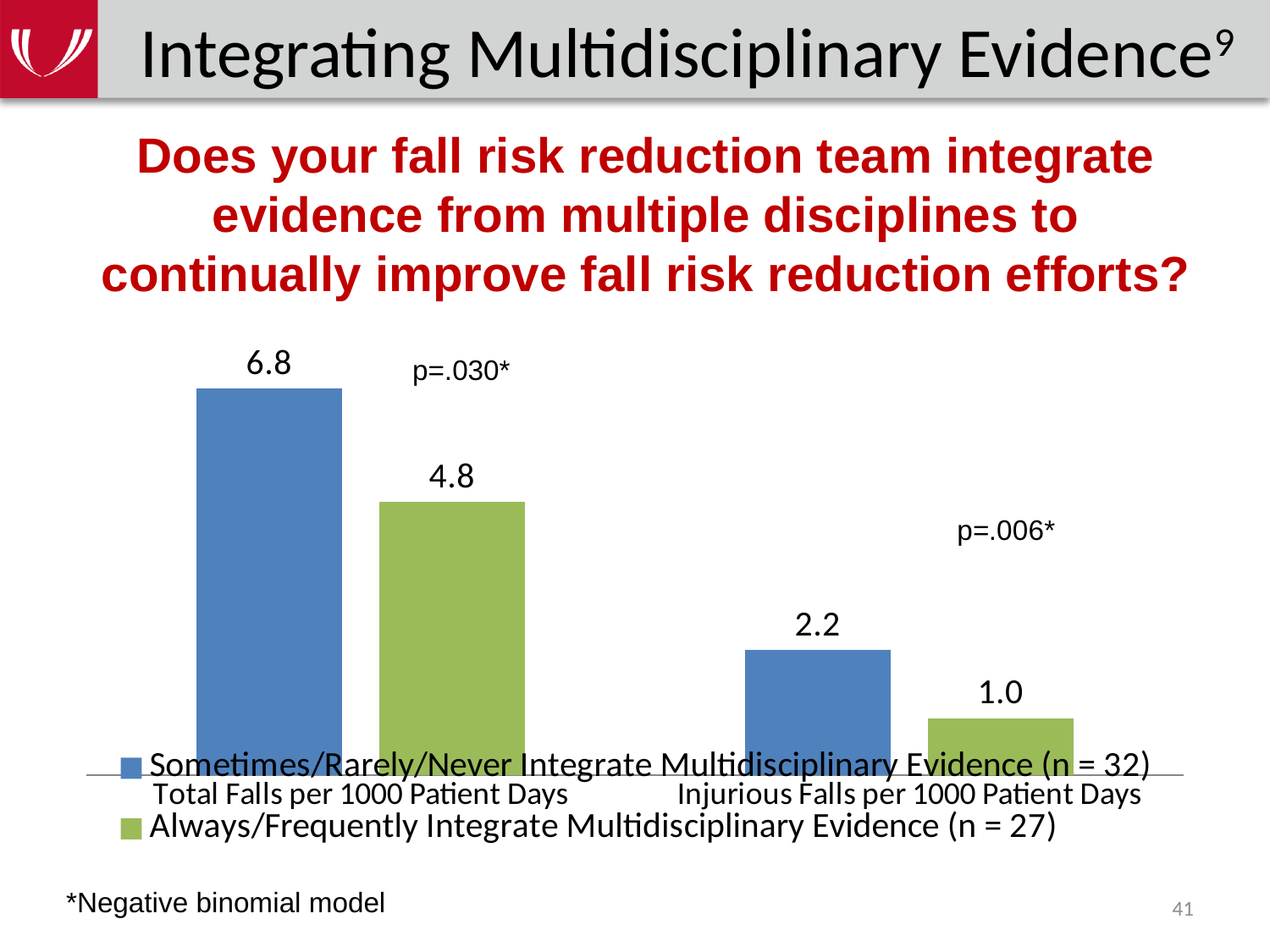
For Injurious Falls per 1000 Patient Days, which group has the larger value? Sometimes/Rarely/Never Integrate Multidisciplinary Evidence (n = 32) Which bar has the lowest value on the chart? Always/Frequently Integrate Multidisciplinary Evidence, Injurious Falls per 1000 Patient Days What is the value for Total Falls per 1000 Patient Days for the Always/Frequently Integrate Multidisciplinary Evidence group? 4.8 What is the difference between the two groups for Total Falls per 1000 Patient Days? 2.0 What is the value for Injurious Falls per 1000 Patient Days for the Always/Frequently Integrate Multidisciplinary Evidence group? 1.0 What is the value for Total Falls per 1000 Patient Days for the Sometimes/Rarely/Never Integrate Multidisciplinary Evidence group? 6.8 What is the difference between the two groups for Injurious Falls per 1000 Patient Days? 1.2 Which bar has the highest value on the chart? Sometimes/Rarely/Never Integrate Multidisciplinary Evidence, Total Falls per 1000 Patient Days How many categories are shown on the x axis? 2 What kind of chart is shown on the slide? Bar chart How many series does the legend list? 2 What is the value for Injurious Falls per 1000 Patient Days for the Sometimes/Rarely/Never Integrate Multidisciplinary Evidence group? 2.2